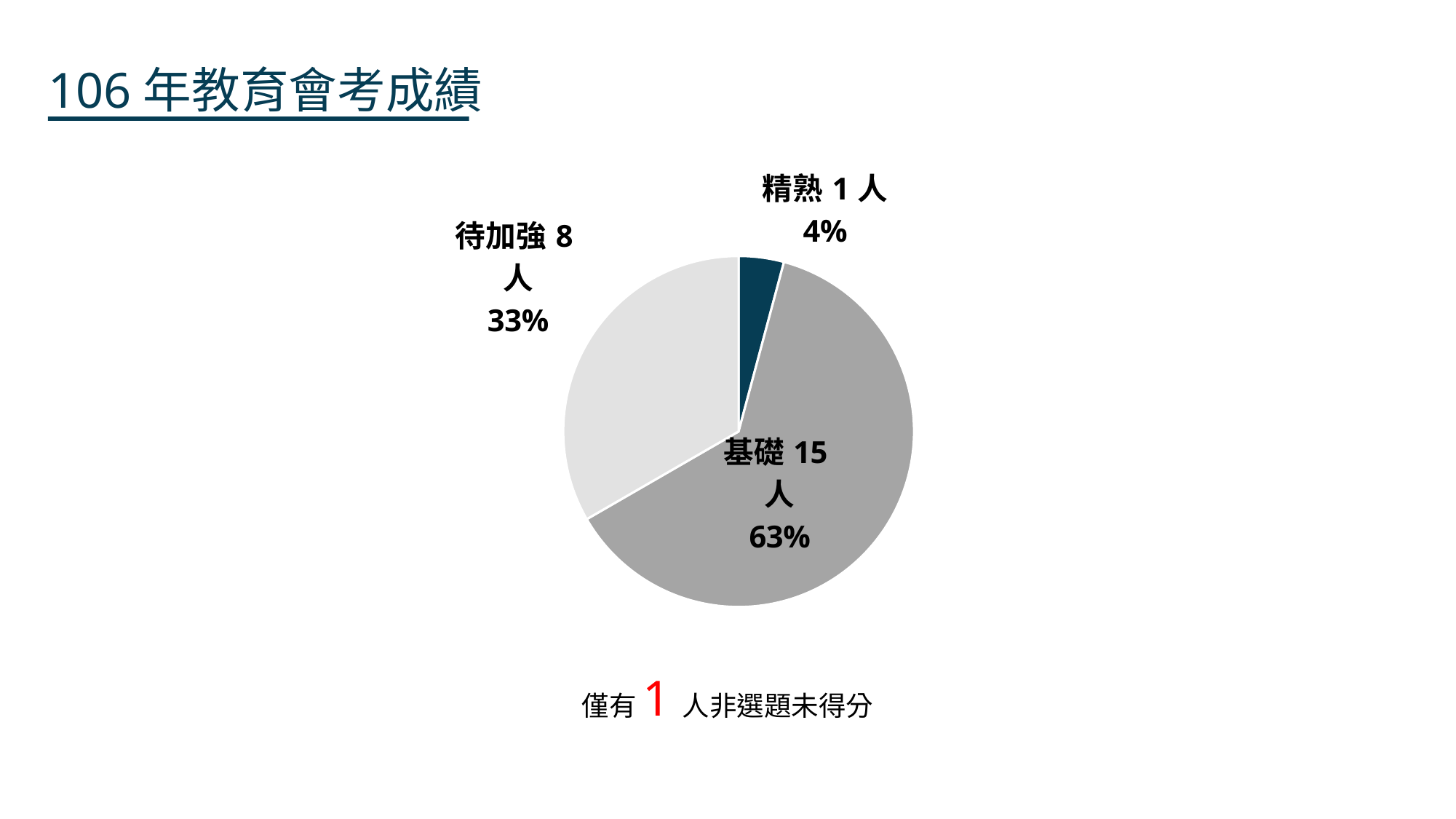
How many people are in the 精熟 category? 1 人 What percentage share does the 基礎 slice have? 63% What percentage share does the 精熟 slice have? 4% How many slices does the pie chart have? 3 What percentage share does the 待加強 slice have? 33% How many people are in the 基礎 category? 15 人 Which category has more people, 待加強 or 精熟? 待加強 How many more people are in 基礎 than in 待加強? 7 Which category has the largest slice? 基礎 Which category has the smallest slice? 精熟 What kind of chart is shown on the slide? pie chart How many people are in the 待加強 category? 8 人